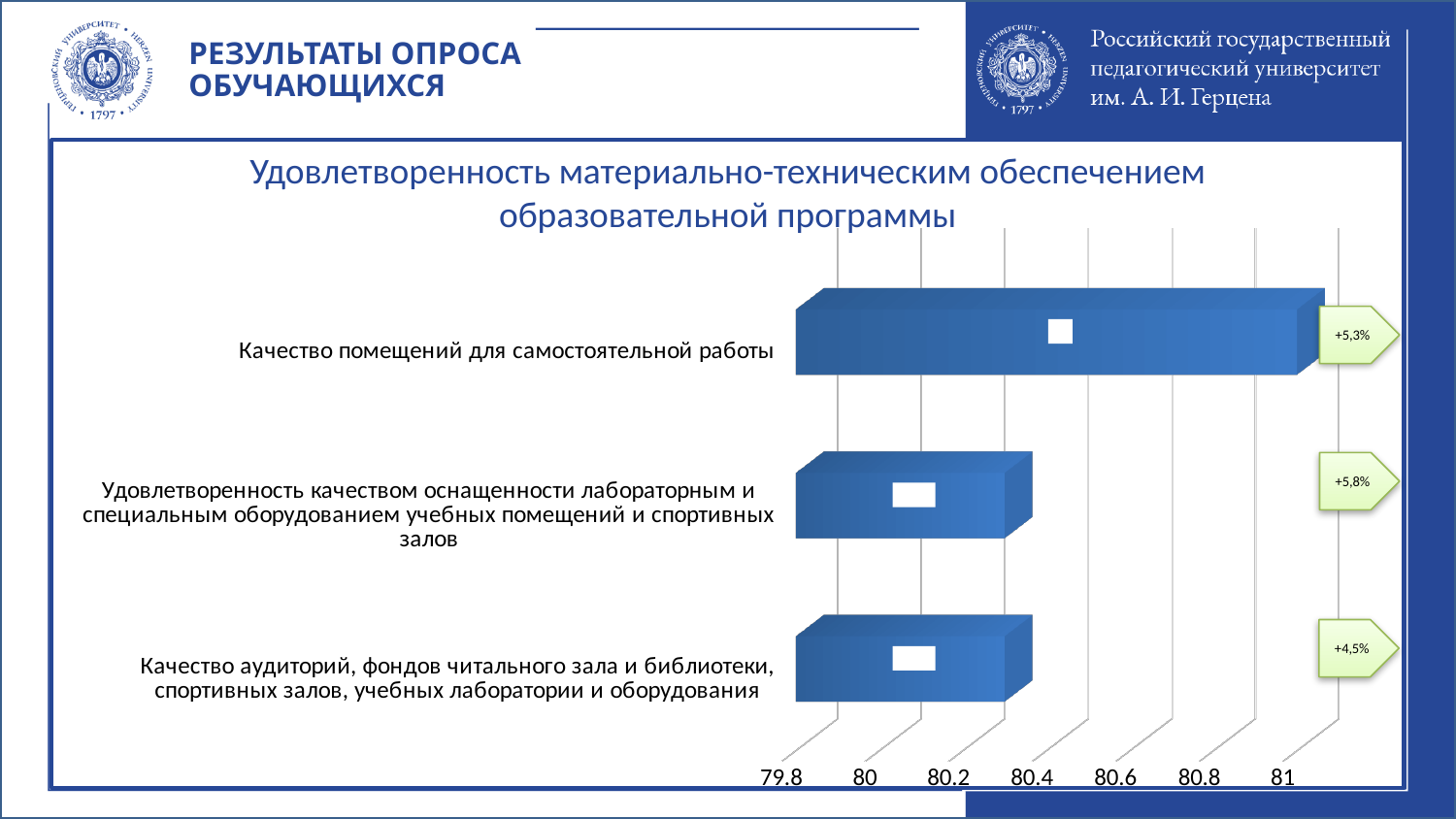
What type of chart is shown on the slide? bar chart Is the value for "Удовлетворенность качеством оснащенности лабораторным и специальным оборудованием учебных помещений и спортивных залов" greater or less than 80.6? less Is the value for "Удовлетворенность качеством оснащенности лабораторным и специальным оборудованием учебных помещений и спортивных залов" greater or less than 80? greater Is the value for "Качество аудиторий, фондов читального зала и библиотеки, спортивных залов, учебных лаборатории и оборудования" greater or less than 80? greater How many categories are plotted in the chart? 3 What is the title of the chart? Удовлетворенность материально-техническим обеспечением образовательной программы What change is shown in the green arrow next to the bar for "Качество помещений для самостоятельной работы"? +5,3% Which is larger: the value for "Качество помещений для самостоятельной работы" or the value for "Качество аудиторий, фондов читального зала и библиотеки, спортивных залов, учебных лаборатории и оборудования"? Качество помещений для самостоятельной работы Which category has the highest value in the chart? Качество помещений для самостоятельной работы